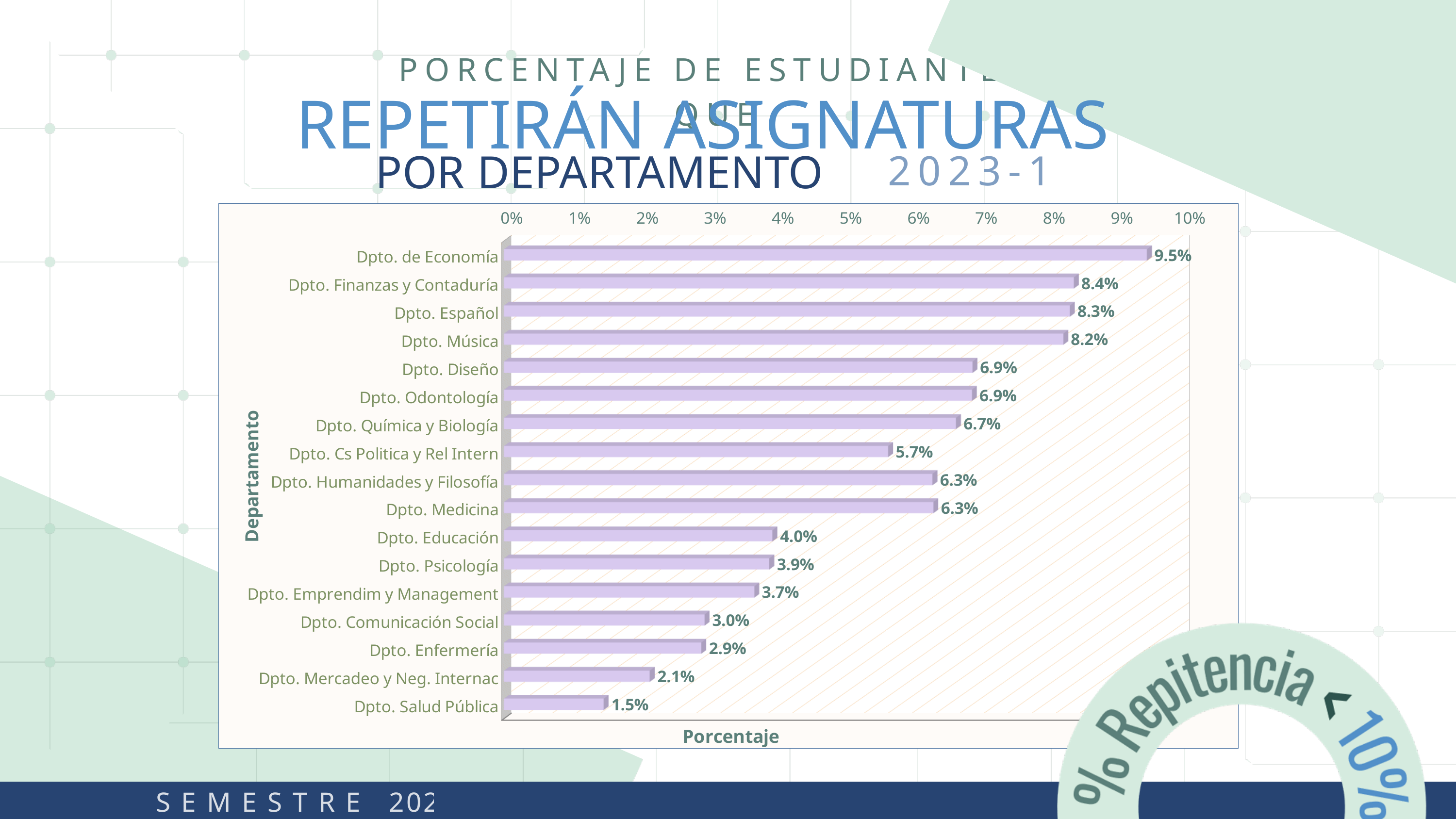
What is the difference between the values for Dpto. de Economía and Dpto. Salud Pública? 8.0% Is the value for Dpto. Diseño greater or less than 5%? greater What is the value for Dpto. Cs Politica y Rel Intern? 5.7% Which department has the highest percentage? Dpto. de Economía What is the difference between the values for Dpto. Finanzas y Contaduría and Dpto. Música? 0.2% What is the value for Dpto. de Economía? 9.5% How many departments are shown in the chart? 17 Which department has the lowest percentage? Dpto. Salud Pública What kind of chart is shown on the slide? bar chart What is the value for Dpto. Enfermería? 2.9% What is the label of the horizontal axis of the chart? Porcentaje Which is larger, the value for Dpto. Educación or the value for Dpto. Comunicación Social? Dpto. Educación